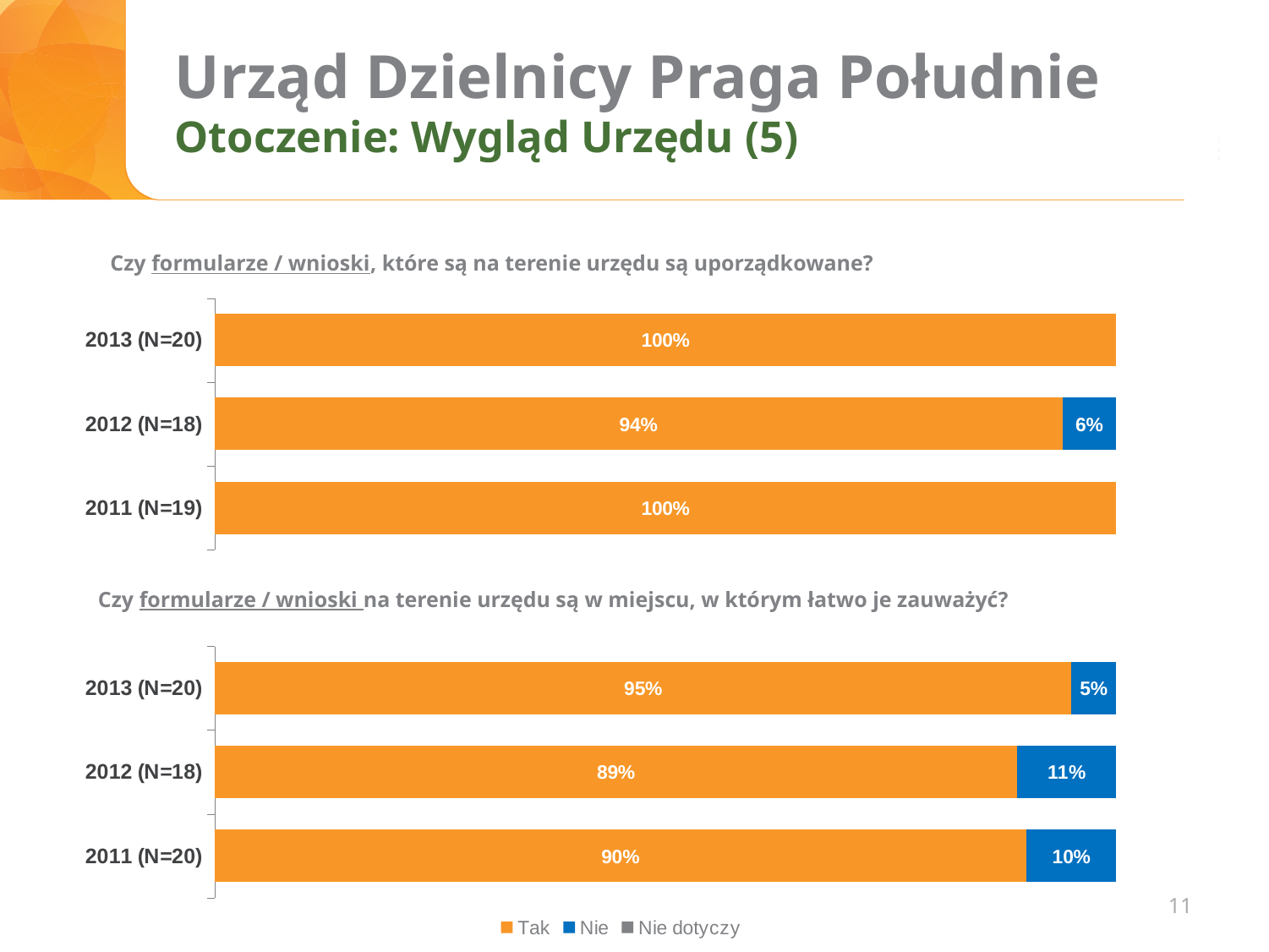
In the bottom chart ("Czy formularze / wnioski na terenie urzędu są w miejscu, w którym łatwo je zauważyć?"), which year has the highest "Tak" value? 2013 (N=20) In the top chart ("Czy formularze / wnioski, które są na terenie urzędu są uporządkowane?"), what is the "Tak" value for 2013 (N=20)? 100% In the bottom chart ("Czy formularze / wnioski na terenie urzędu są w miejscu, w którym łatwo je zauważyć?"), what is the difference between the "Tak" values for 2013 (N=20) and 2012 (N=18)? 6% In the top chart ("Czy formularze / wnioski, które są na terenie urzędu są uporządkowane?"), what is the "Nie" value for 2012 (N=18)? 6% What type of chart is the bottom chart ("Czy formularze / wnioski na terenie urzędu są w miejscu, w którym łatwo je zauważyć?")? Stacked bar chart In the bottom chart ("Czy formularze / wnioski na terenie urzędu są w miejscu, w którym łatwo je zauważyć?"), what is the "Nie" value for 2011 (N=20)? 10% In the bottom chart ("Czy formularze / wnioski na terenie urzędu są w miejscu, w którym łatwo je zauważyć?"), what is the "Tak" value for 2012 (N=18)? 89% In the bottom chart ("Czy formularze / wnioski na terenie urzędu są w miejscu, w którym łatwo je zauważyć?"), which year has the lowest "Tak" value? 2012 (N=18) In the top chart ("Czy formularze / wnioski, które są na terenie urzędu są uporządkowane?"), what is the "Tak" value for 2012 (N=18)? 94% In the bottom chart ("Czy formularze / wnioski na terenie urzędu są w miejscu, w którym łatwo je zauważyć?"), is the "Nie" value larger for 2012 (N=18) or 2013 (N=20)? 2012 (N=18) How many series does the legend at the bottom of the slide list? 3 How many year categories does the top chart ("Czy formularze / wnioski, które są na terenie urzędu są uporządkowane?") show? 3